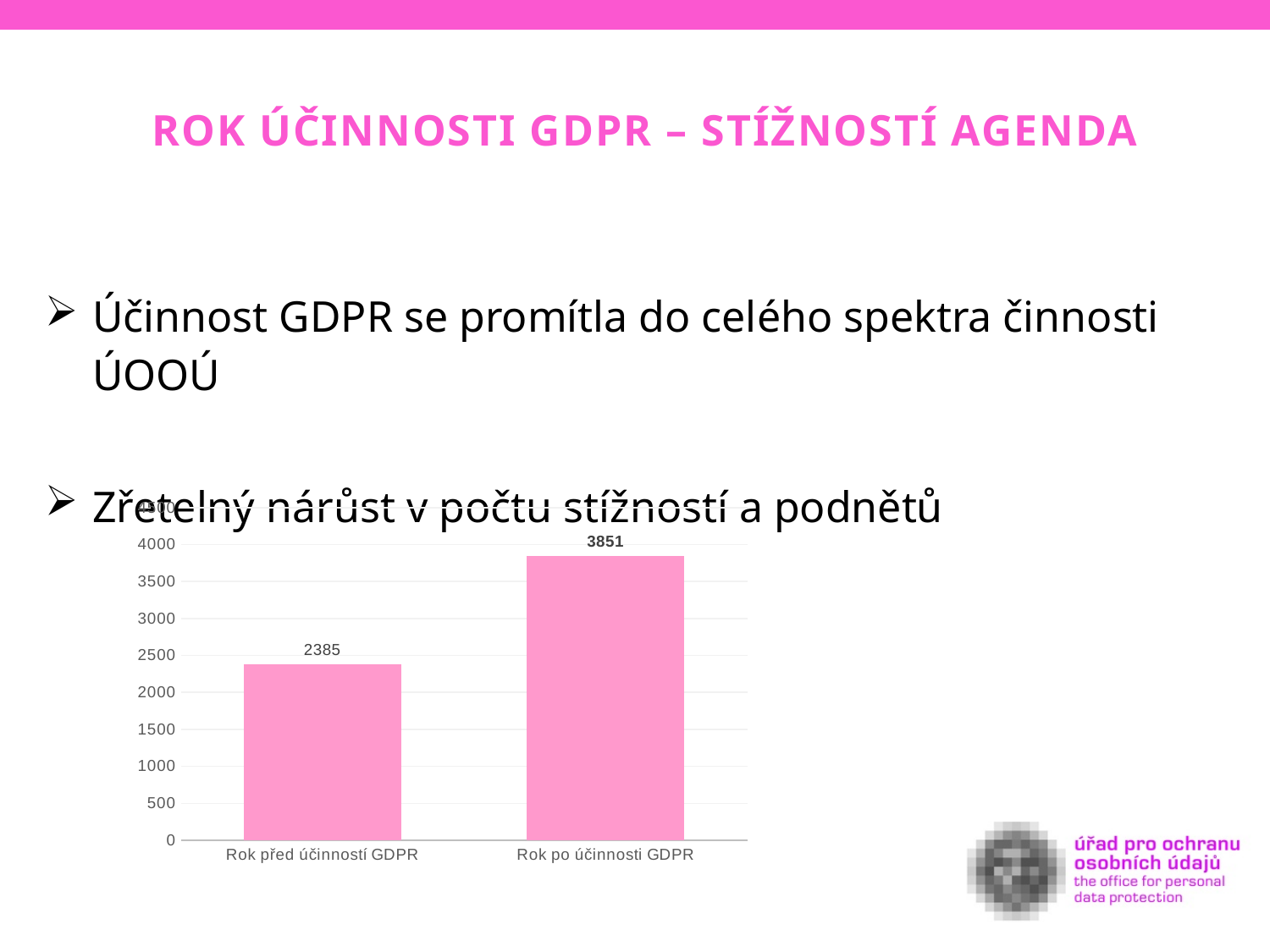
Which category has the lowest value? Rok před účinností GDPR Is the value for "Rok po účinnosti GDPR" greater or less than 3500? greater Do the values rise or fall from left to right along the x axis? rise Is the value for "Rok před účinností GDPR" greater or less than 2500? less What is the value for "Rok před účinností GDPR"? 2385 What is the difference between the values for "Rok po účinnosti GDPR" and "Rok před účinností GDPR"? 1466 Which is larger: the value for "Rok před účinností GDPR" or the value for "Rok po účinnosti GDPR"? Rok po účinnosti GDPR How many categories are shown on the chart? 2 What kind of chart is shown on the slide? bar chart Which category has the highest value? Rok po účinnosti GDPR What is the value for "Rok po účinnosti GDPR"? 3851 What colour are the bars in the chart? pink